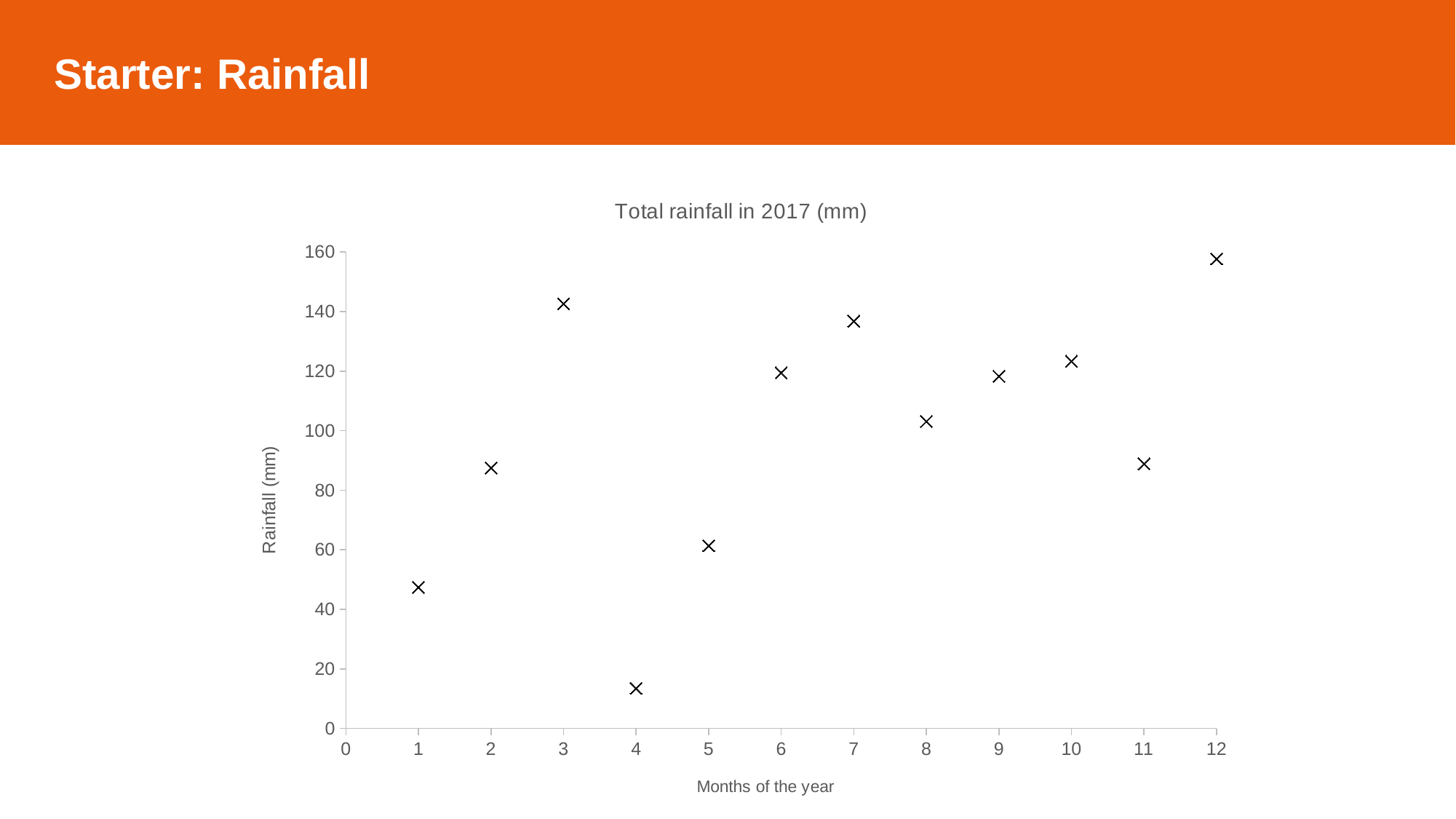
Is the rainfall for month 1 greater or less than 60? less Which month has the lowest rainfall? 4 How many data points are plotted on the chart? 12 Which month has more rainfall, month 1 or month 5? 5 What kind of chart is shown on the slide? Scatter chart Is the rainfall for month 4 greater or less than 20? less Which month has more rainfall, month 7 or month 8? 7 Is the rainfall for month 12 greater or less than 140? greater What is the title of the chart? Total rainfall in 2017 (mm) What is the label of the vertical axis? Rainfall (mm) Which month has the highest rainfall? 12